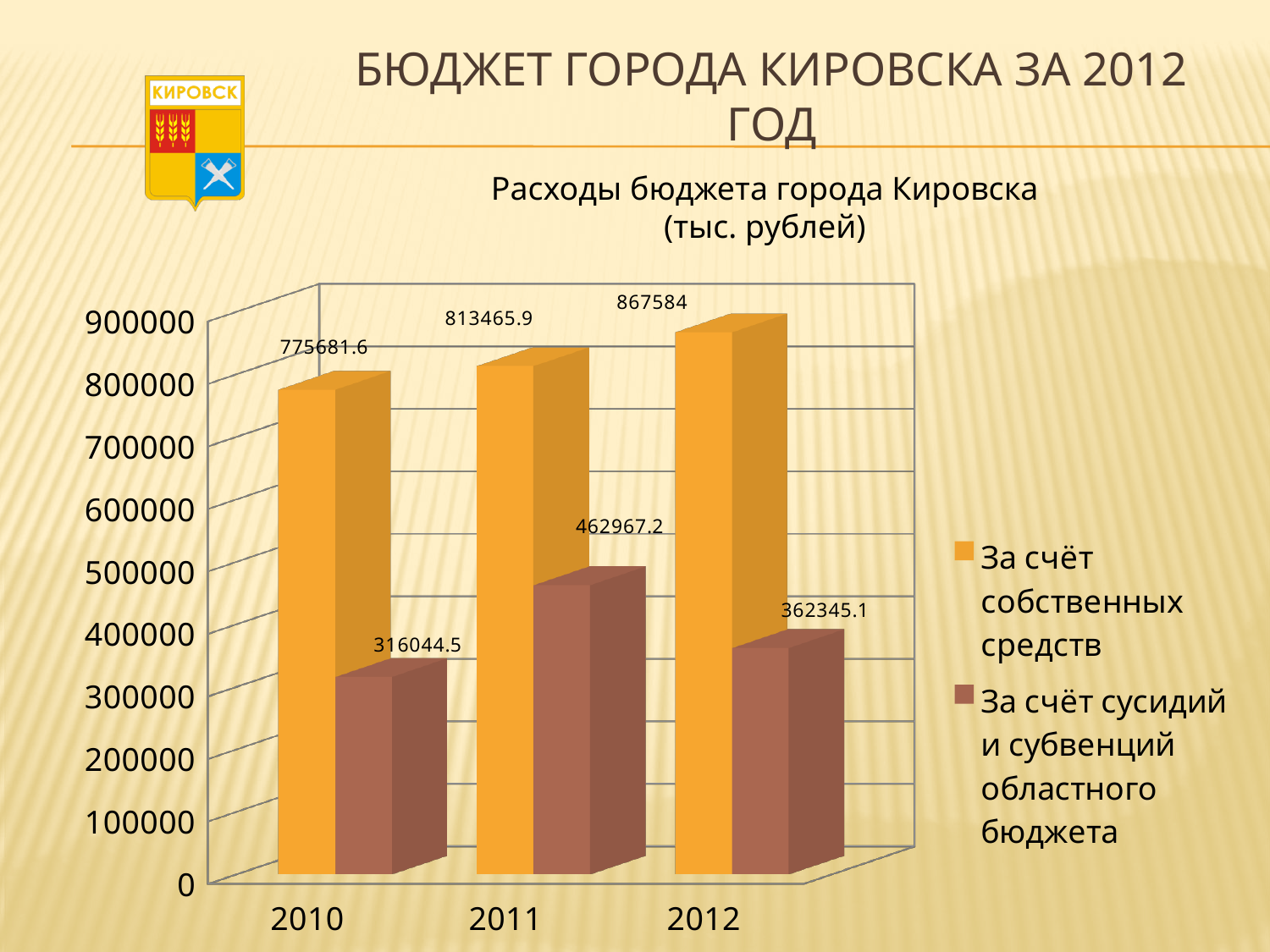
In which year is the value for 'За счёт сусидий и субвенций областного бюджета' highest? 2011 What kind of chart is shown on the slide? Bar chart What is the difference between the 'За счёт сусидий и субвенций областного бюджета' values for 2011 and 2010? 146922.7 What is the difference between the 'За счёт собственных средств' values for 2012 and 2010? 91902.4 What is the value for 'За счёт сусидий и субвенций областного бюджета' in 2011? 462967.2 In which year is the value for 'За счёт собственных средств' lowest? 2010 How many series does the legend list? 2 Do the values for 'За счёт собственных средств' rise or fall from 2010 to 2012? Rise How many years are shown on the x axis? 3 What is the value for 'За счёт собственных средств' in 2012? 867584 Which is larger: 'За счёт сусидий и субвенций областного бюджета' in 2012 or in 2010? 2012 What is the value for 'За счёт собственных средств' in 2010? 775681.6